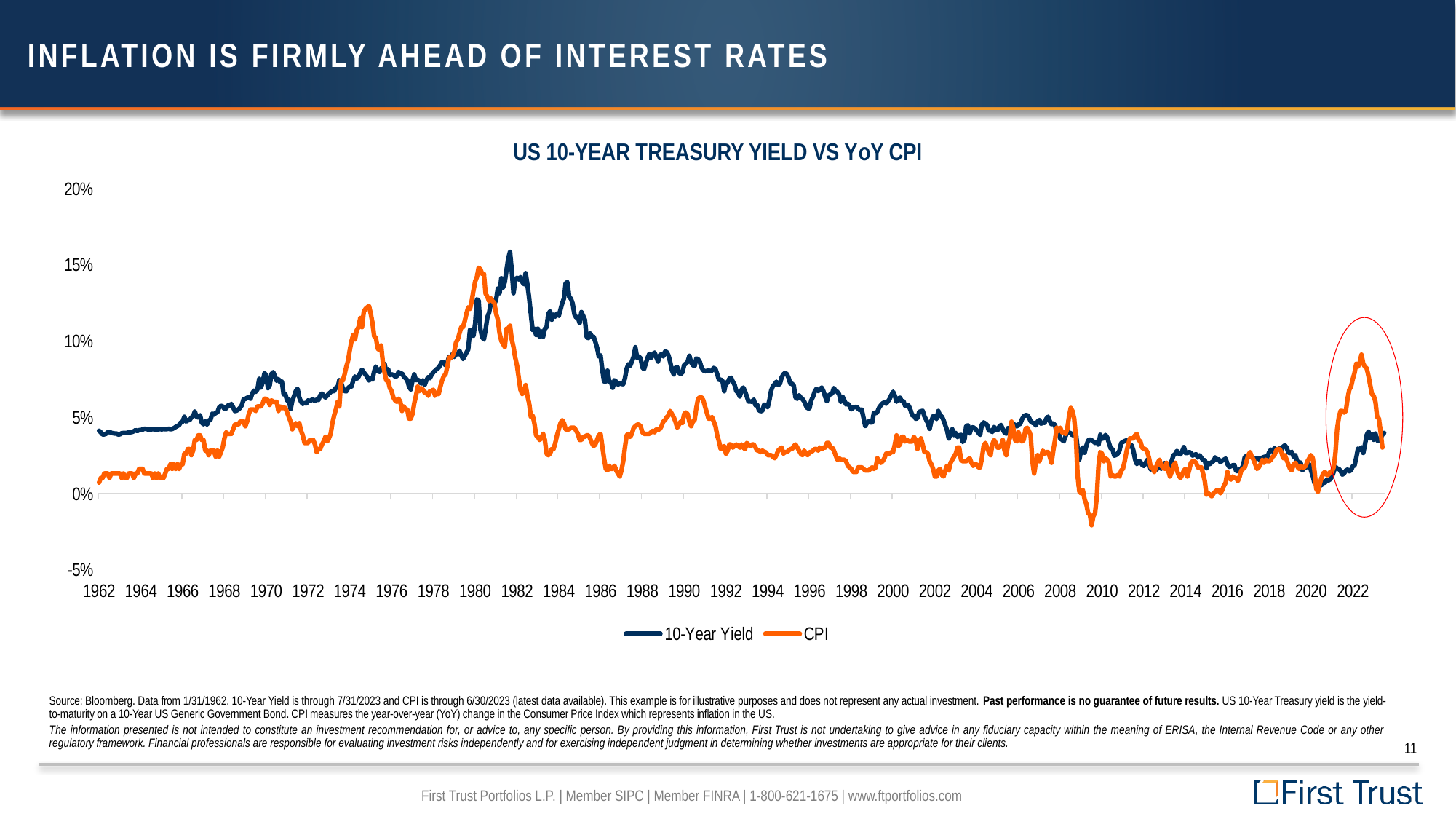
What kind of chart is shown on the slide? Line chart What is the title of the chart? US 10-YEAR TREASURY YIELD VS YoY CPI How many series does the legend list? 2 Around 1990, which series is higher, 10-Year Yield or CPI? 10-Year Yield At the 2022 peak, which series is higher, 10-Year Yield or CPI? CPI Which series is drawn in orange? CPI Is the CPI value at its 2022 peak greater or less than 5%? greater Is the 10-Year Yield value in 2020 greater or less than 5%? less Is the CPI value at its low point around 2009 greater or less than 0%? less Does the 10-Year Yield generally rise or fall from 1982 to 2020? Fall